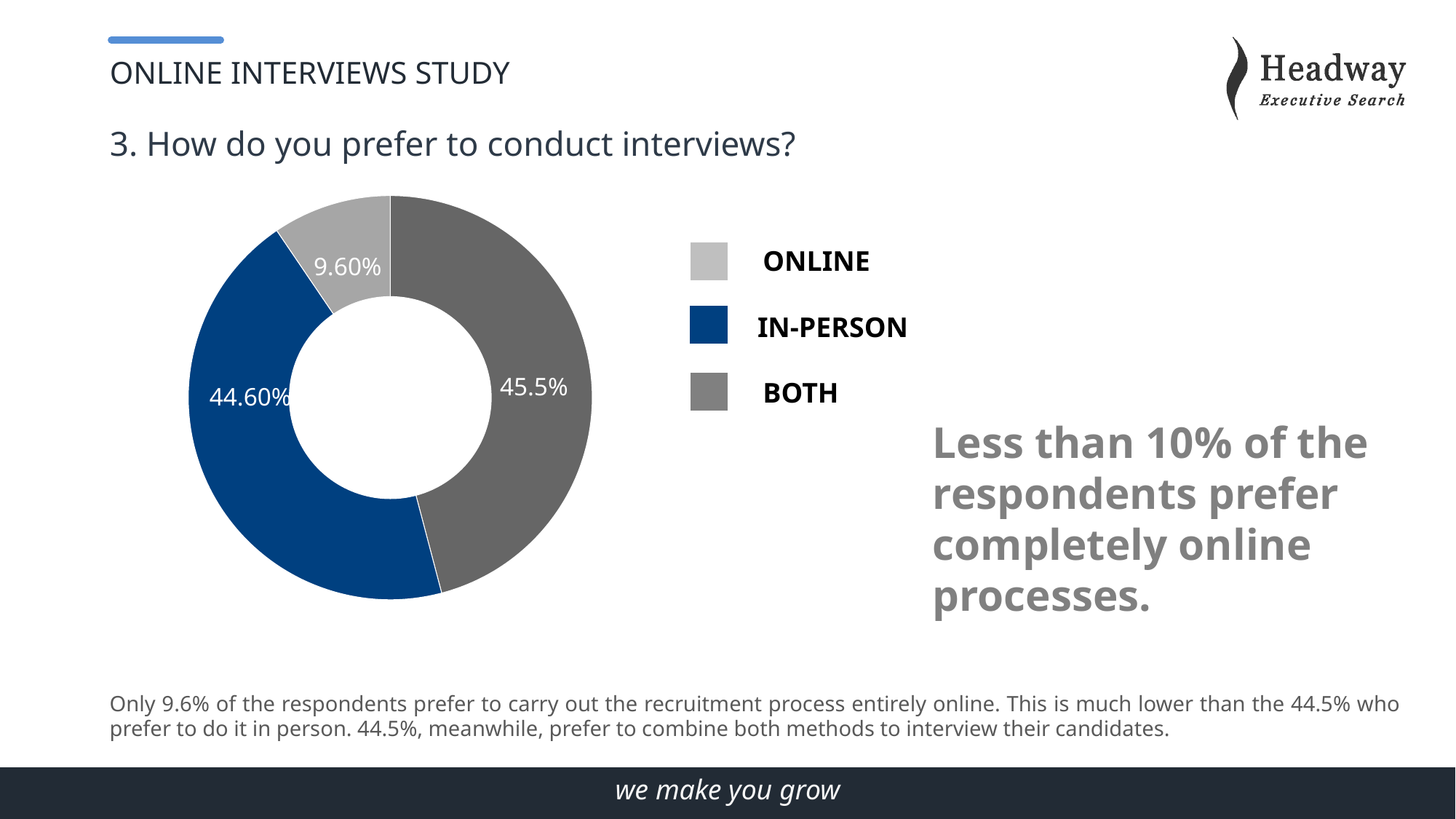
Which colour represents the IN-PERSON category in the chart? Blue Which is larger: the share for IN-PERSON or the share for ONLINE? IN-PERSON What kind of chart is shown on the slide? doughnut chart What is the difference in percentage points between the BOTH share and the IN-PERSON share? 0.9 percentage points What percentage of respondents prefer in-person interviews? 44.60% Which category has the largest share of the pie? BOTH What is the difference in percentage points between the IN-PERSON share and the ONLINE share? 35 percentage points What percentage of respondents prefer both methods? 45.5% What percentage of respondents prefer to conduct interviews online? 9.60% Which category has the smallest share of the pie? ONLINE How many categories are shown in the chart? 3 Which is larger: the share for BOTH or the share for IN-PERSON? BOTH